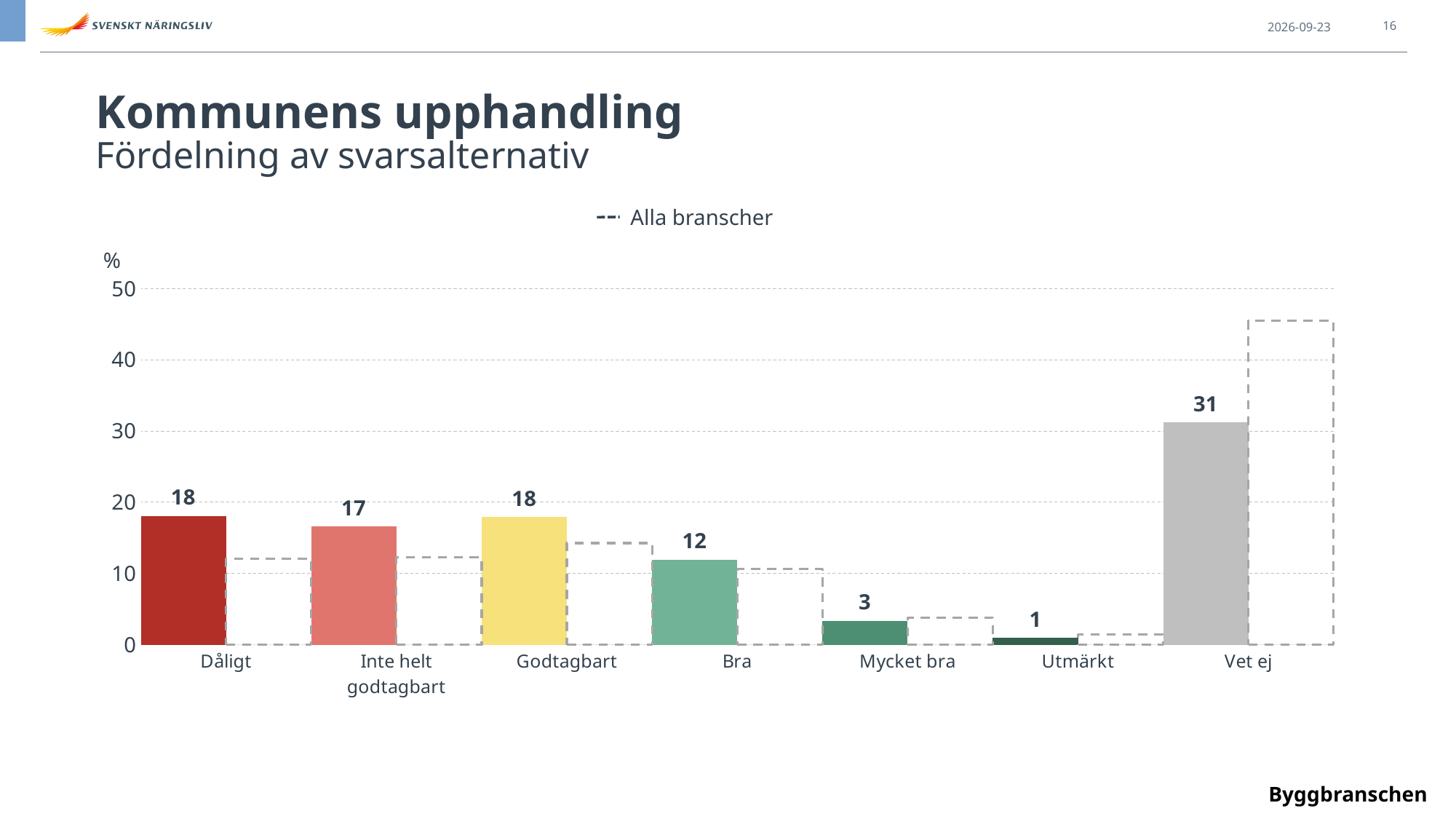
What is the legend entry shown above the chart? Alla branscher What is the value for Inte helt godtagbart? 17 Is the dashed Alla branscher value for Vet ej greater or less than 40? greater Which category has the lowest value? Utmärkt Which category has the highest value? Vet ej What kind of chart is shown on the slide? bar chart What is the difference between the values for Vet ej and Dåligt? 13 How many categories are shown on the x axis? 7 What is the value for Mycket bra? 3 What is the value for Bra? 12 Which is larger, the value for Bra or the value for Mycket bra? Bra What is the value for Vet ej? 31